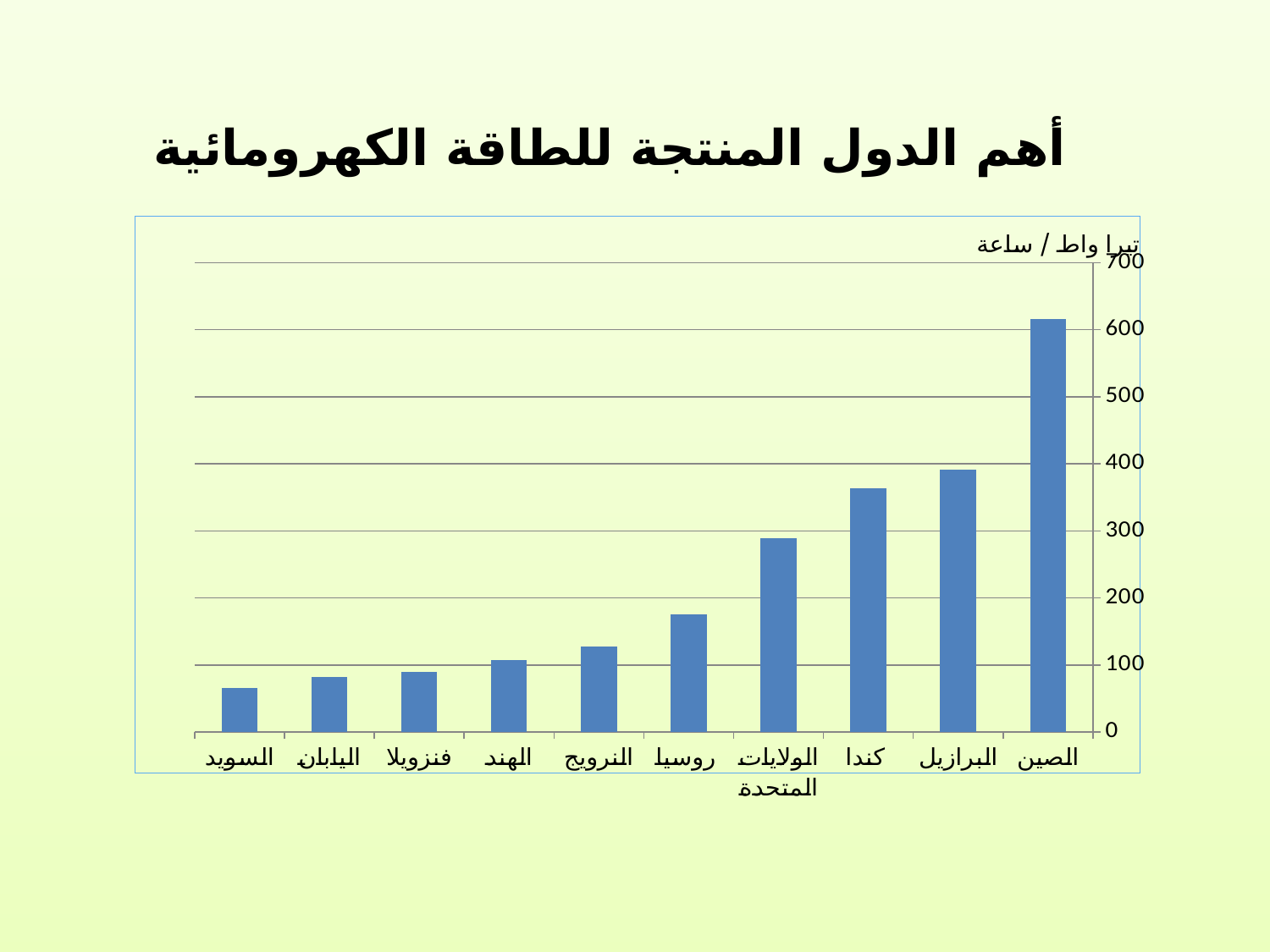
What kind of chart is shown on the slide? bar chart Do the values rise or fall moving from الصين on the right to السويد on the left? fall Which country has the highest value on the chart? الصين Which has a larger value, البرازيل or كندا? البرازيل Which country has the lowest value on the chart? السويد How many countries are plotted on the chart? 10 Is the value for روسيا greater or less than 200? less Is the value for الصين greater or less than 500? greater What unit is shown on the chart's value axis label? تيرا واط / ساعة Is the value for كندا greater or less than 300? greater